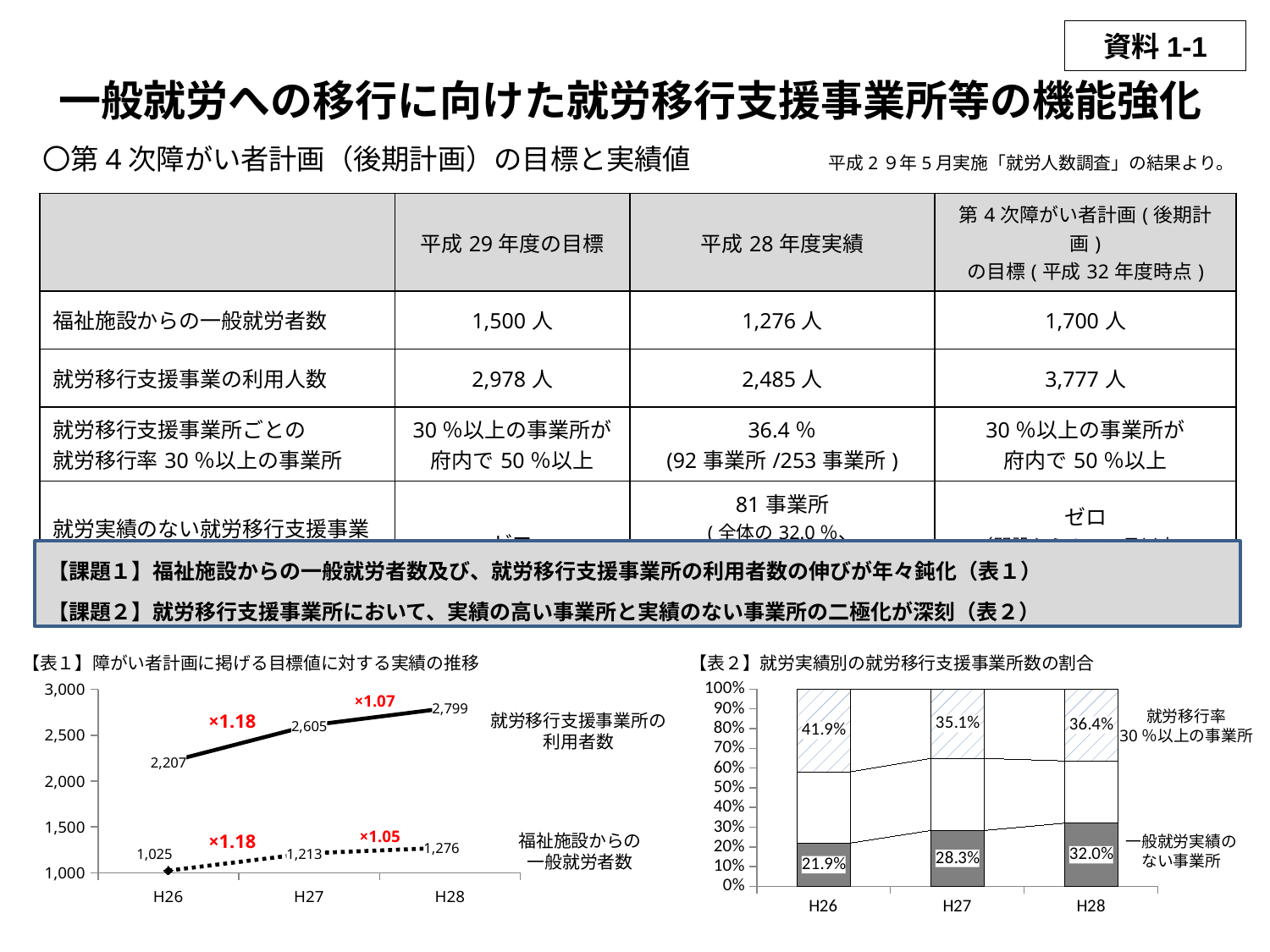
【表2】のグラフは何種類のグラフですか？ 積み上げ棒グラフ 【表2】のグラフで、一般就労実績のない事業所の割合が最も低い年度はどれですか？ H26 【表1】のグラフは何種類のグラフですか？ 折れ線グラフ 【表2】のグラフで、H28の就労移行率30％以上の事業所の割合と一般就労実績のない事業所の割合の差は何ポイントですか？ 4.4% 【表1】のグラフで、就労移行支援事業所の利用者数のH26からH27への増加分はいくつですか？ 398 【表2】のグラフで、H27の一般就労実績のない事業所の割合は何％ですか？ 28.3% 【表1】のグラフで、福祉施設からの一般就労者数はH26からH28にかけて増加していますか、減少していますか？ 増加 【表2】のグラフで、就労移行率30％以上の事業所の割合が最も高い年度はどれですか？ H26 【表1】のグラフで、H27からH28への福祉施設からの一般就労者数の伸び率として表示されている倍率は何ですか？ ×1.05 【表1】のグラフには何本の系列がありますか？ 2 【表1】のグラフで、H26の福祉施設からの一般就労者数はいくつですか？ 1,025 【表1】のグラフで、H28の就労移行支援事業所の利用者数はいくつですか？ 2,799